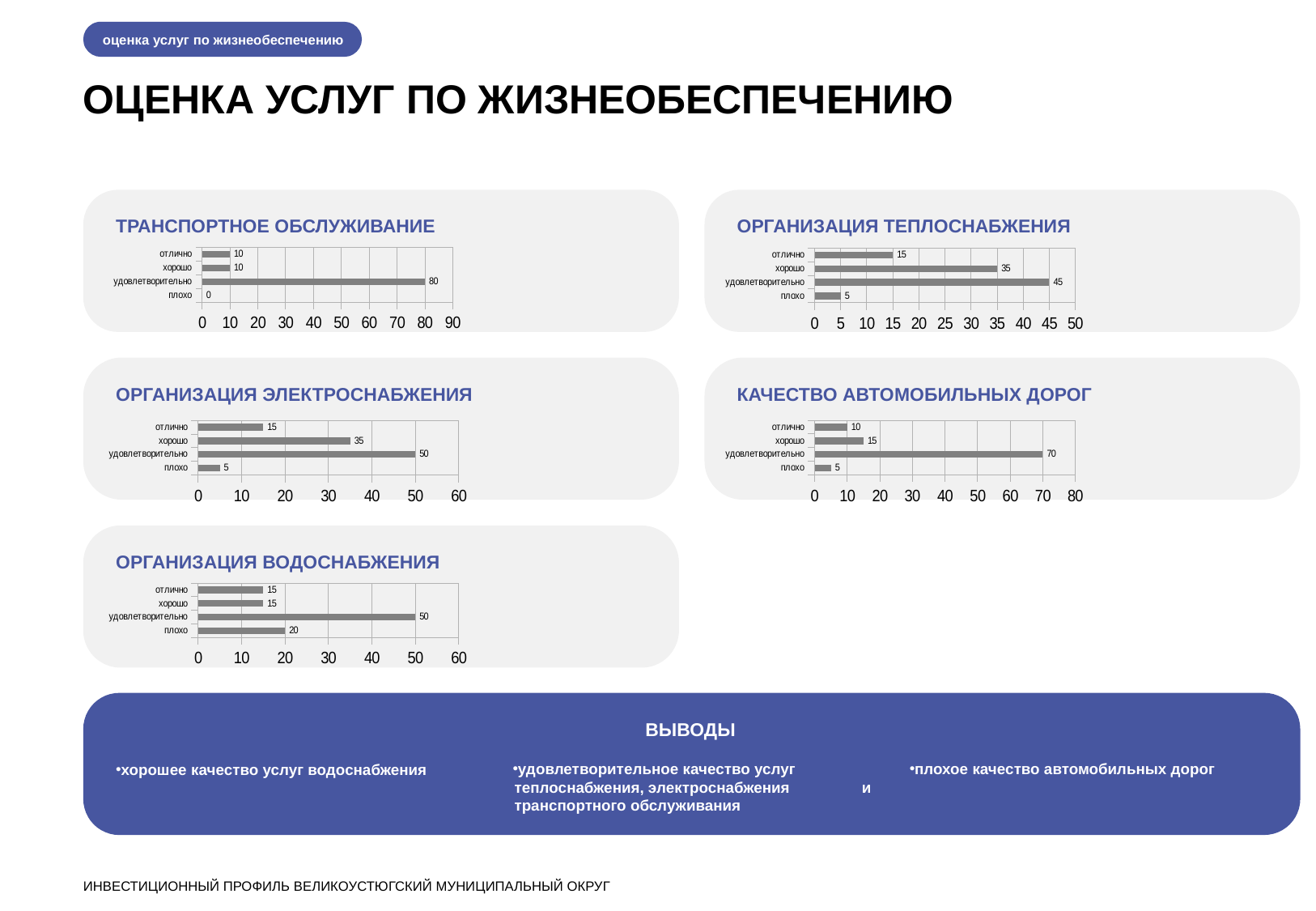
In the 'ОРГАНИЗАЦИЯ ВОДОСНАБЖЕНИЯ' chart, what is the difference between 'удовлетворительно' and 'плохо'? 30 In the 'ОРГАНИЗАЦИЯ ЭЛЕКТРОСНАБЖЕНИЯ' chart, which category has the lowest value? плохо In the 'ОРГАНИЗАЦИЯ ЭЛЕКТРОСНАБЖЕНИЯ' chart, what is the value for 'хорошо'? 35 In the 'КАЧЕСТВО АВТОМОБИЛЬНЫХ ДОРОГ' chart, what is the value for 'удовлетворительно'? 70 In the 'КАЧЕСТВО АВТОМОБИЛЬНЫХ ДОРОГ' chart, which is larger, 'хорошо' or 'отлично'? хорошо What type of chart is the 'ТРАНСПОРТНОЕ ОБСЛУЖИВАНИЕ' chart? Bar chart In the 'ОРГАНИЗАЦИЯ ВОДОСНАБЖЕНИЯ' chart, what is the value for 'плохо'? 20 In the 'ОРГАНИЗАЦИЯ ТЕПЛОСНАБЖЕНИЯ' chart, which category has the highest value? удовлетворительно In the 'ОРГАНИЗАЦИЯ ТЕПЛОСНАБЖЕНИЯ' chart, what is the difference between 'хорошо' and 'отлично'? 20 In the 'ТРАНСПОРТНОЕ ОБСЛУЖИВАНИЕ' chart, what is the value for 'удовлетворительно'? 80 In the 'ТРАНСПОРТНОЕ ОБСЛУЖИВАНИЕ' chart, what is the value for 'плохо'? 0 How many categories does the 'ОРГАНИЗАЦИЯ ВОДОСНАБЖЕНИЯ' chart show? 4